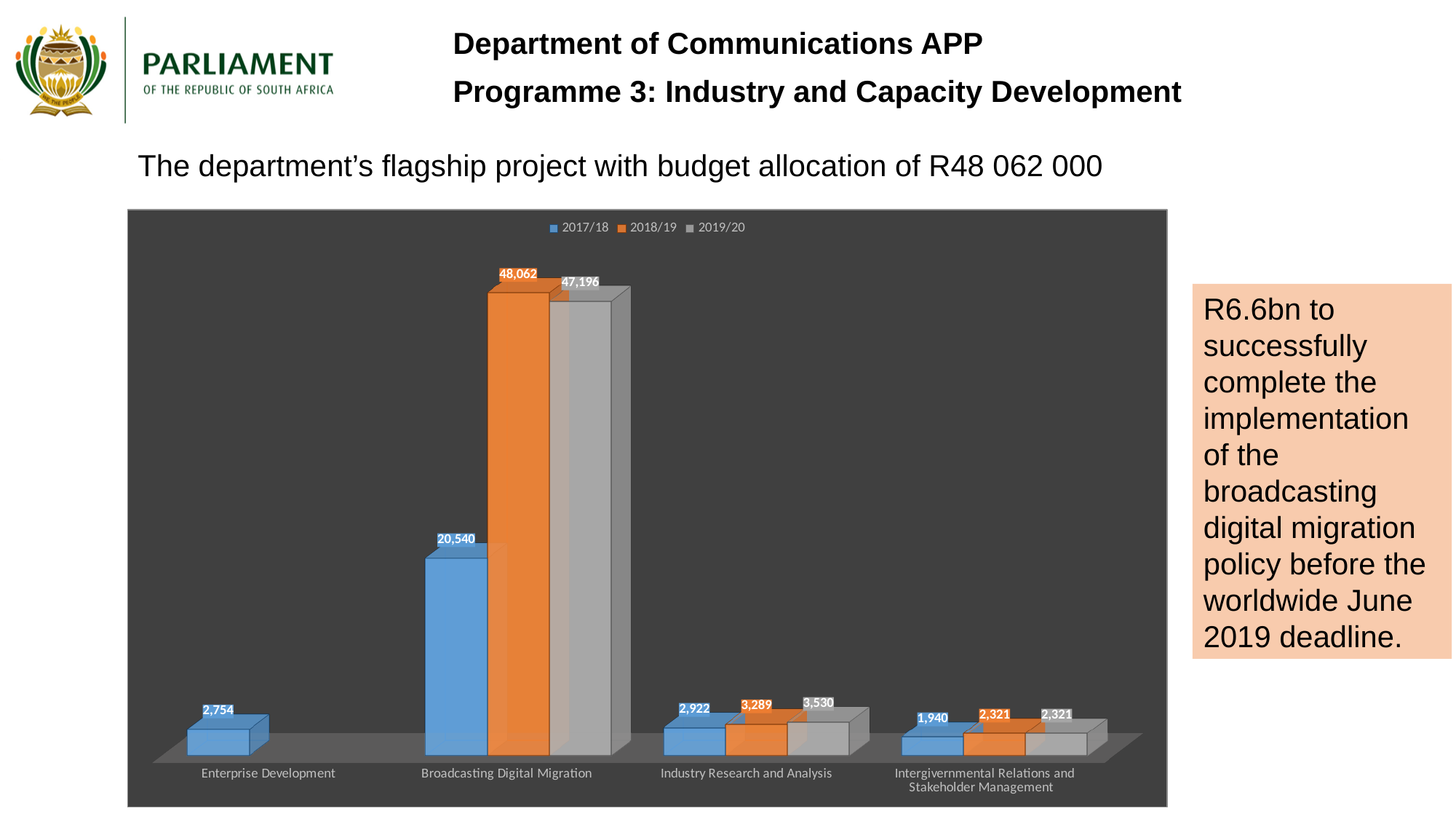
How many series does the legend list? 3 What is the value for Intergivernmental Relations and Stakeholder Management in 2017/18? 1,940 Which category has the highest value in the 2017/18 series? Broadcasting Digital Migration What is the difference between the 2018/19 and 2017/18 values for Broadcasting Digital Migration? 27,522 What is the value for Industry Research and Analysis in 2019/20? 3,530 What is the value for Enterprise Development in 2017/18? 2,754 What is the value for Broadcasting Digital Migration in 2018/19? 48,062 Which category has the lowest value in the 2017/18 series? Intergivernmental Relations and Stakeholder Management Which is larger for Broadcasting Digital Migration: the 2018/19 value or the 2019/20 value? 2018/19 What is the difference between the 2019/20 and 2018/19 values for Industry Research and Analysis? 241 What kind of chart is shown on the slide? Bar chart How many categories are shown on the x axis? 4